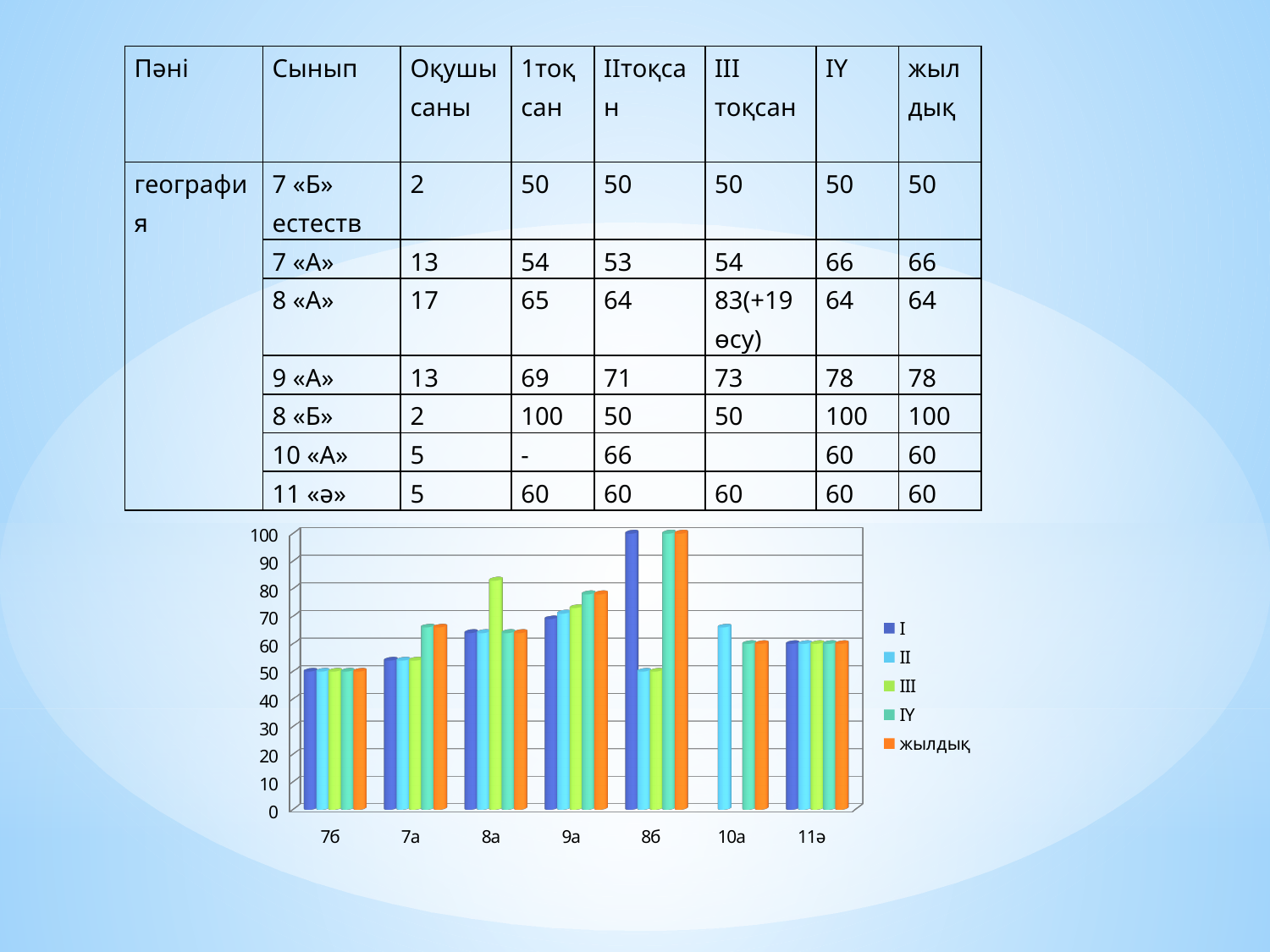
What is the value of series I for category 7б in the chart? 50 Which category has the lowest value for the жылдық series in the chart? 7б What is the value of series I for category 8б in the chart? 100 How many categories are shown along the x axis of the chart? 7 Which category has the highest value for series I in the chart? 8б How many series does the chart legend list? 5 What kind of chart is shown on the slide? bar chart Is the value of series III for category 8а greater or less than 80? greater Is the value of series IY for category 9а greater or less than 70? greater For category 7а, which is larger: series I or series IY? IY What is the value of the жылдық series for category 11ә in the chart? 60 How many bars are plotted for category 10а in the chart? 3